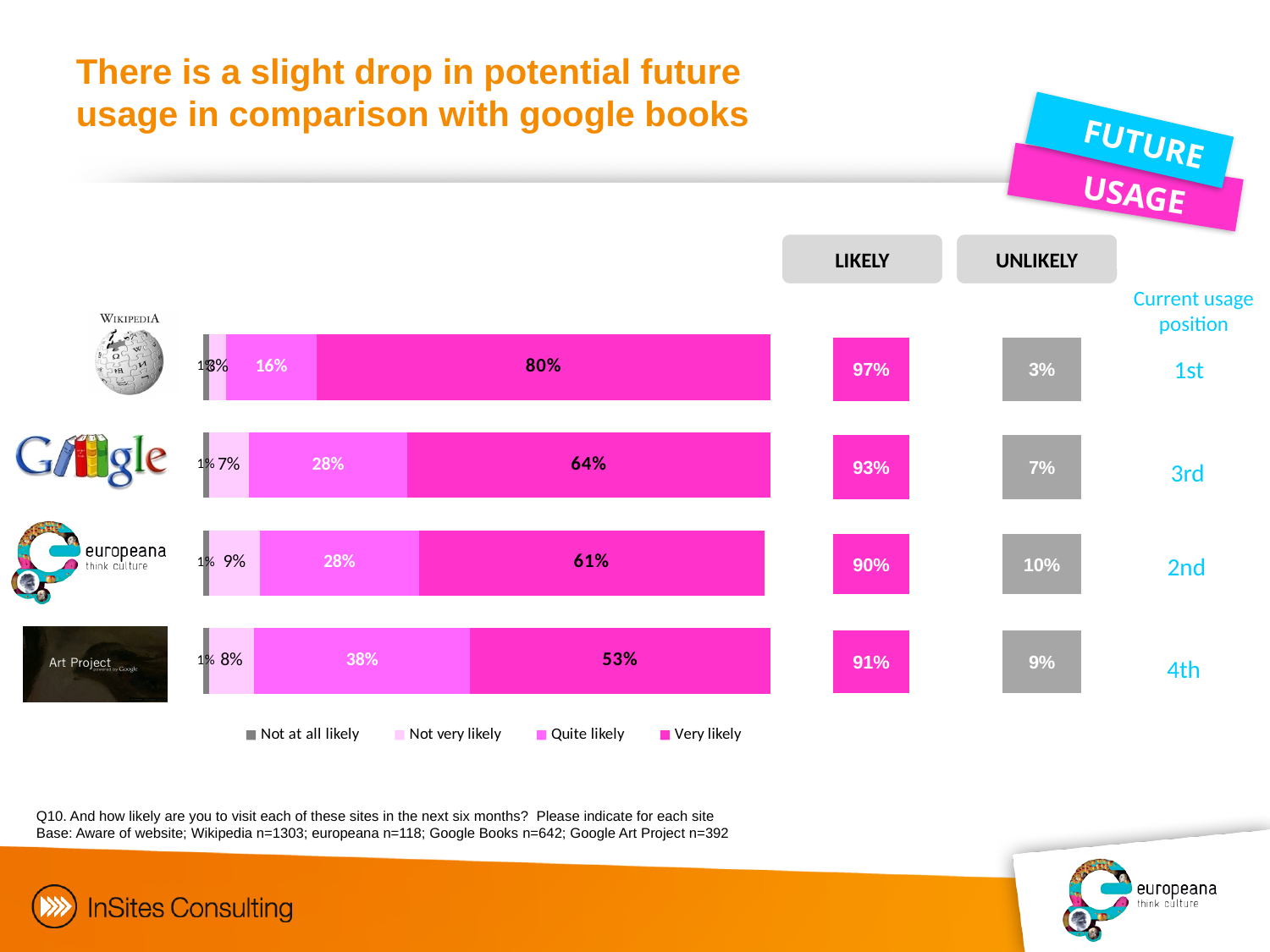
What is the 'Not very likely' value for Google Books? 7% What is the 'LIKELY' percentage shown for europeana? 90% What is the 'Very likely' value for Wikipedia? 80% How many series does the legend list? 4 How many sites are shown in the chart? 4 What is the 'Very likely' value for europeana? 61% What kind of chart is shown on the slide? Stacked bar chart Which site has the lowest 'Very likely' value? Art Project Which is larger, the 'Quite likely' value for Art Project or for europeana? Art Project Which site has the highest 'Very likely' value? Wikipedia What is the 'Quite likely' value for Google Art Project? 38% What is the difference between the 'Very likely' values for Google Books and europeana? 3%